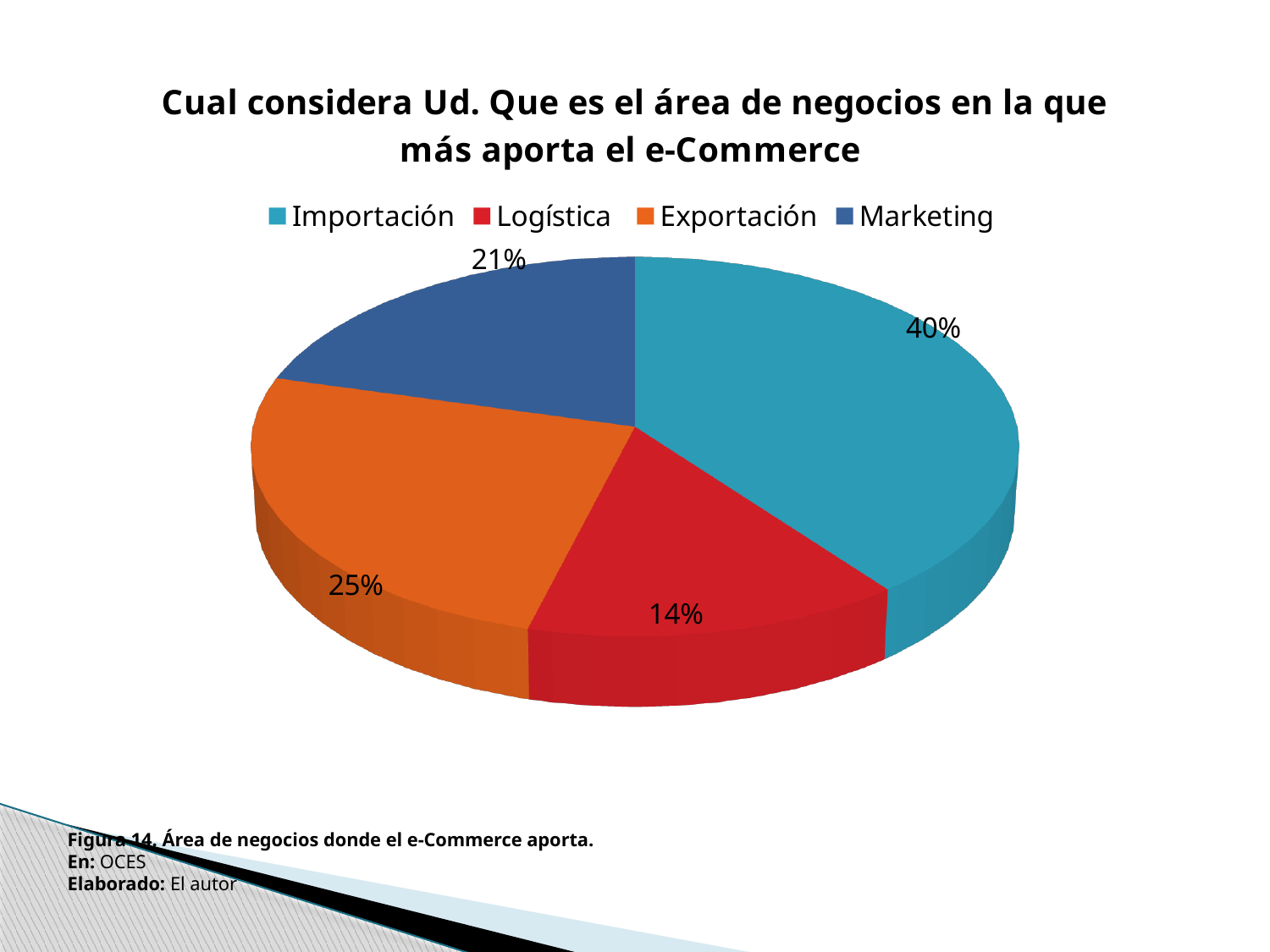
Which has a larger share, Exportación or Marketing? Exportación What percentage of the pie does Importación represent? 40% How many categories are shown in the pie chart? 4 Which business area has the largest share of the pie? Importación What percentage of the pie does Logística represent? 14% What percentage of the pie does Marketing represent? 21% What colour is the slice for Exportación? Orange What is the combined share of Exportación and Marketing? 46% What is the difference in percentage points between Importación and Logística? 26 What percentage of the pie does Exportación represent? 25% What kind of chart is shown on the slide? Pie chart Which business area has the smallest share of the pie? Logística